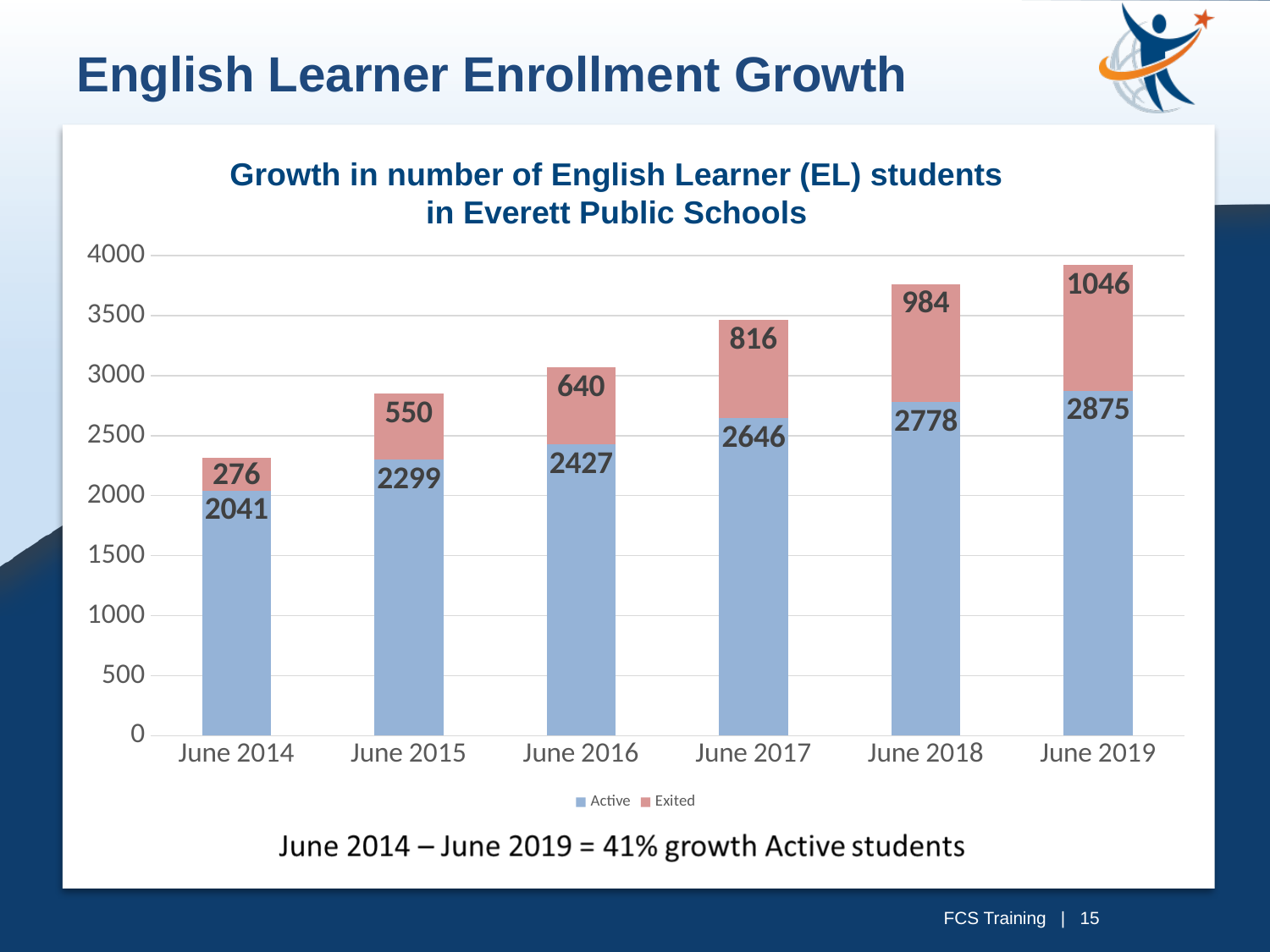
Which is larger, the Exited value for June 2018 or the Exited value for June 2016? June 2018 What kind of chart is shown? Stacked bar chart How many years are shown on the x axis? 6 Which year has the lowest Exited value? June 2014 What is the total of the stacked bar for June 2014? 2317 What is the Exited value for June 2015? 550 What is the Active value for June 2017? 2646 Do the Active values rise or fall from June 2014 to June 2019? Rise Which year has the highest Active value? June 2019 How many series does the legend list? 2 What is the total of the stacked bar for June 2019? 3921 What is the difference between the Active values for June 2019 and June 2014? 834